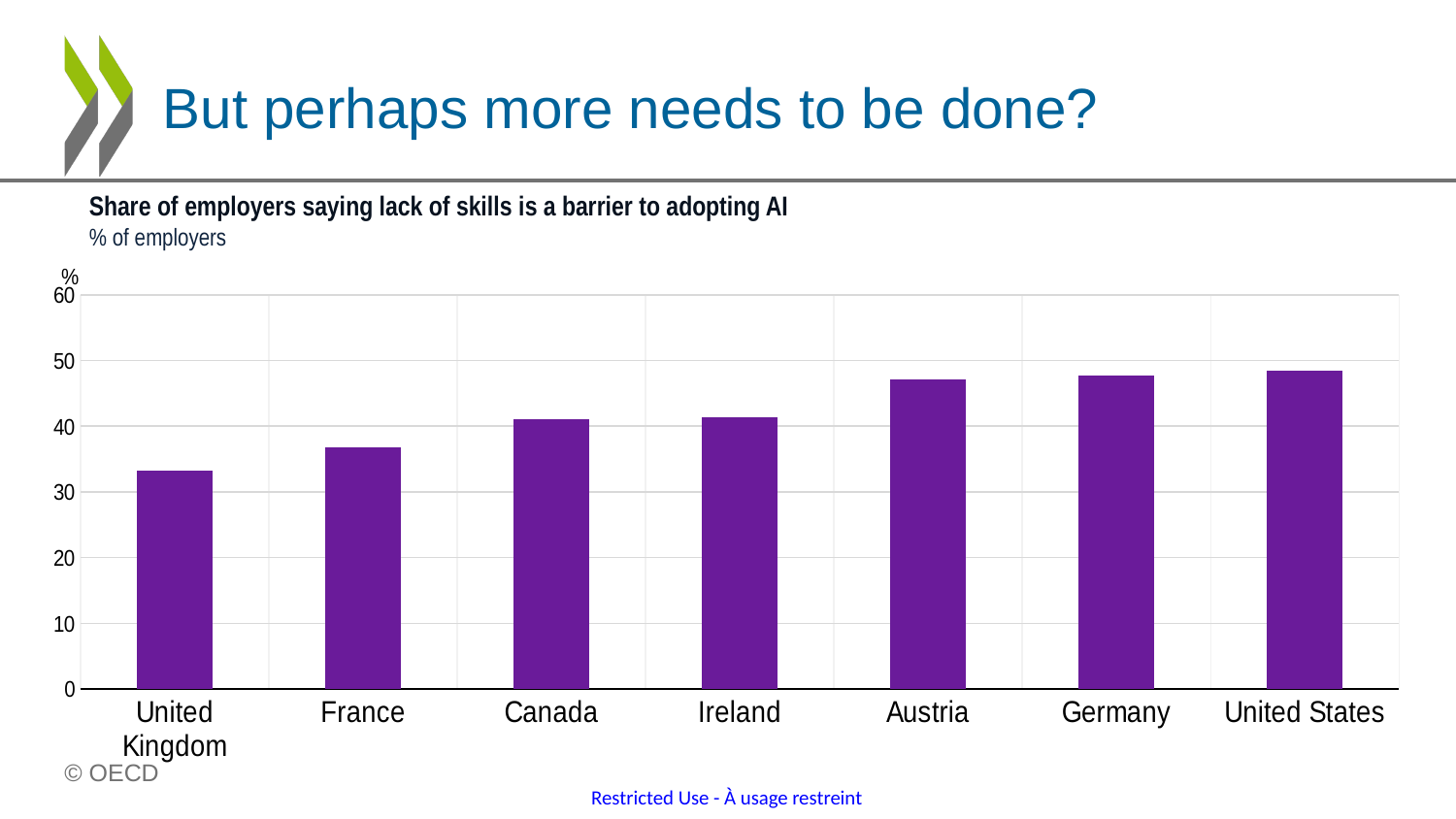
Which has a higher value, France or Canada? Canada Is the value for Austria greater or less than 50? less What is the title of the chart? Share of employers saying lack of skills is a barrier to adopting AI How many countries are shown on the x axis of the chart? 7 Which country has the lowest share of employers saying lack of skills is a barrier to adopting AI? United Kingdom Is the value for Canada greater or less than 40? greater Do the values rise or fall moving from left to right along the x axis? rise What kind of chart is shown on the slide? bar chart Is the value for the United Kingdom greater or less than 40? less Which has a higher value, the United Kingdom or Austria? Austria